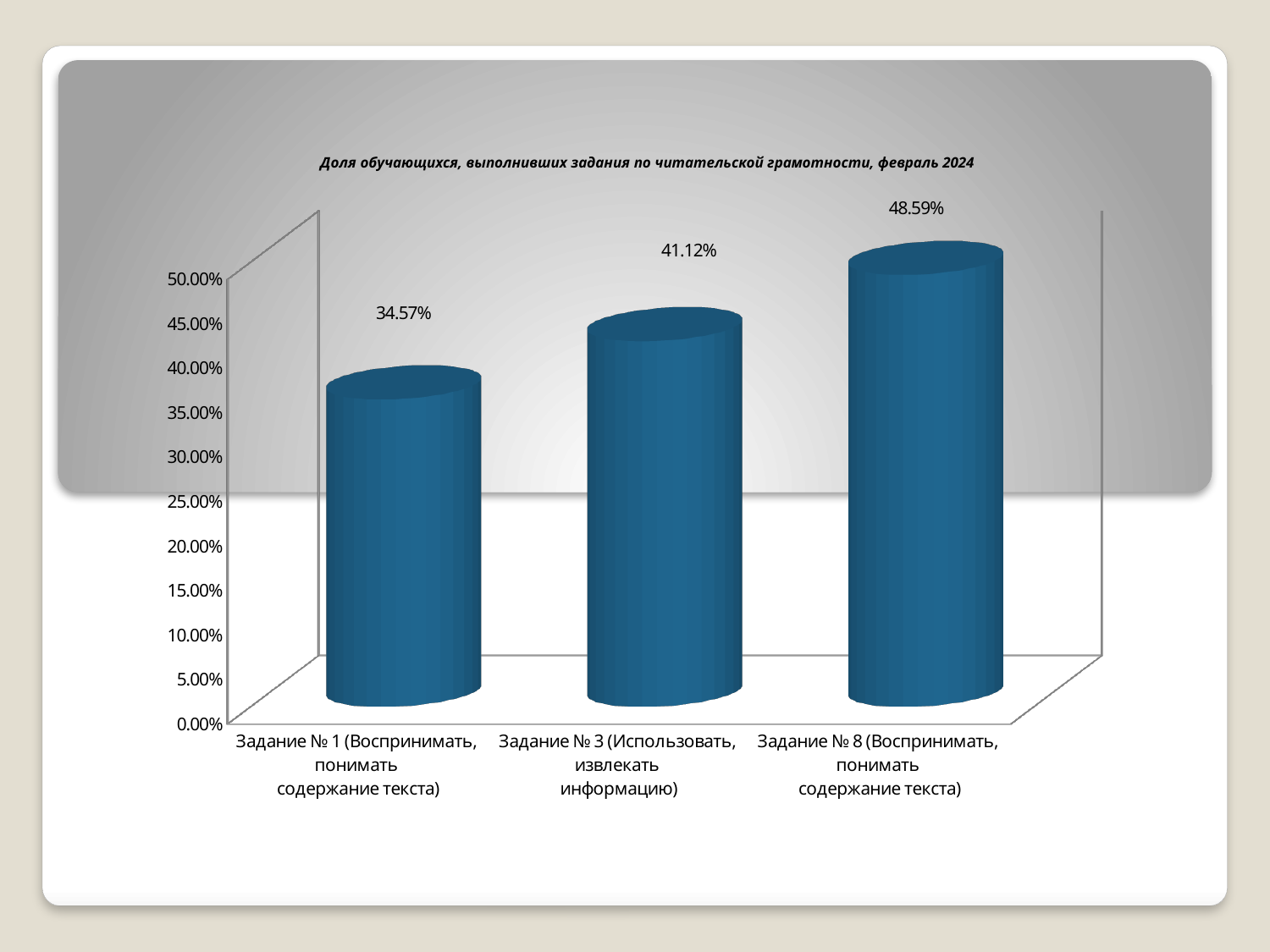
What is the value for Задание № 1 (Воспринимать, понимать содержание текста)? 34.57% What is the difference between the values for Задание № 3 and Задание № 1? 6.55% Which is larger, the value for Задание № 3 or the value for Задание № 8? Задание № 8 How many tasks (categories) are shown in the chart? 3 Which task has the lowest share of students who completed it? Задание № 1 (Воспринимать, понимать содержание текста) What is the value for Задание № 8 (Воспринимать, понимать содержание текста)? 48.59% Is the value for Задание № 3 greater or less than 40.00%? greater What kind of chart is shown on the slide? Bar chart What is the difference between the values for Задание № 8 and Задание № 1? 14.02% Do the values rise or fall from left to right across the tasks? Rise Which task has the highest share of students who completed it? Задание № 8 (Воспринимать, понимать содержание текста) What is the value for Задание № 3 (Использовать, извлекать информацию)? 41.12%